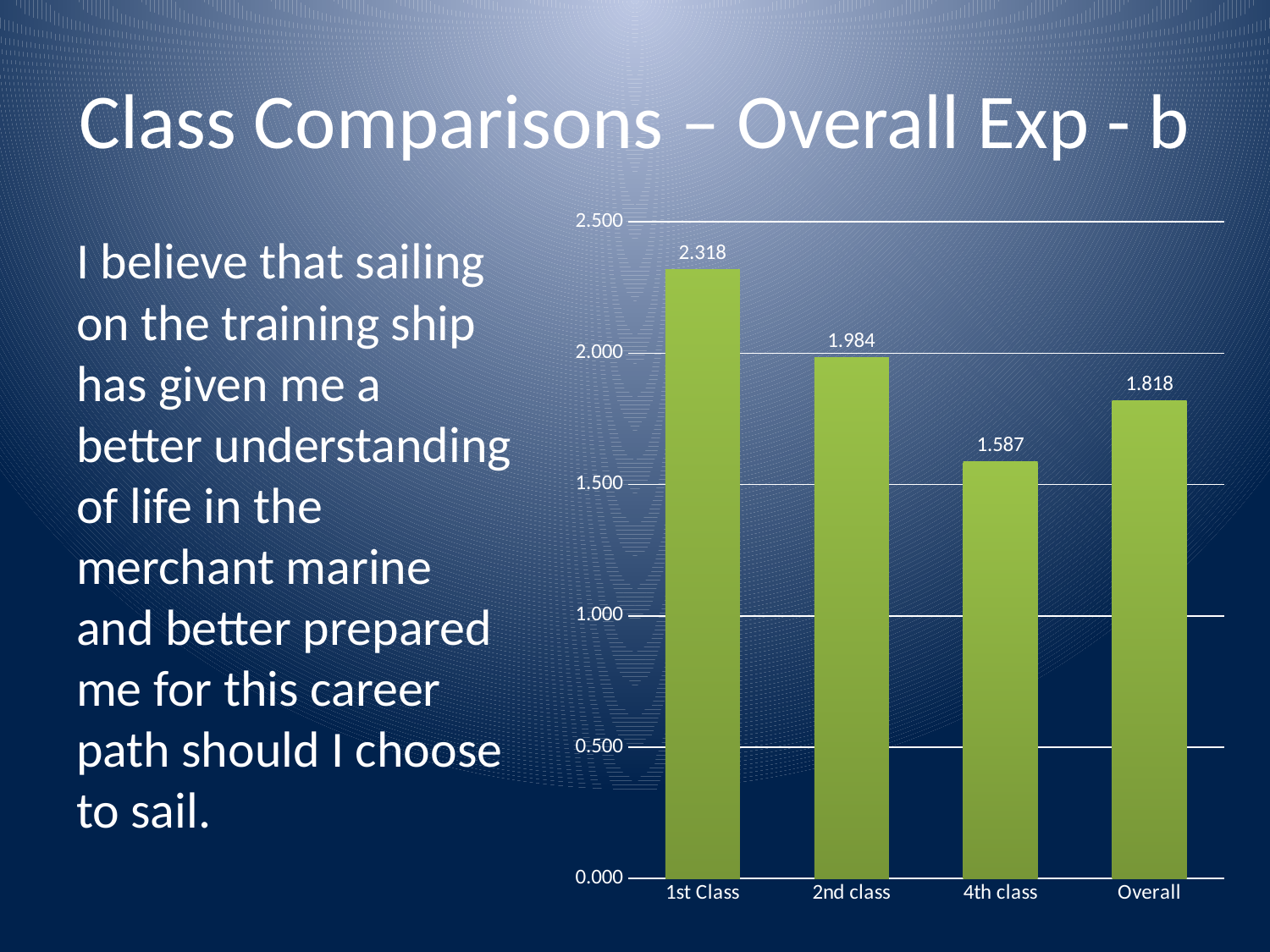
What is the value for Overall? 1.818 What kind of chart is shown on the slide? bar chart Which category has the lowest value? 4th class What is the value for 2nd class? 1.984 Which is larger, the value for 2nd class or the value for Overall? 2nd class Is the value for 4th class greater or less than 1.500? greater What is the highest value shown on the vertical axis? 2.500 What is the value for 1st Class? 2.318 What is the difference between the values for 1st Class and 4th class? 0.731 What is the value for 4th class? 1.587 How many categories are shown on the x axis? 4 Which category has the highest value? 1st Class